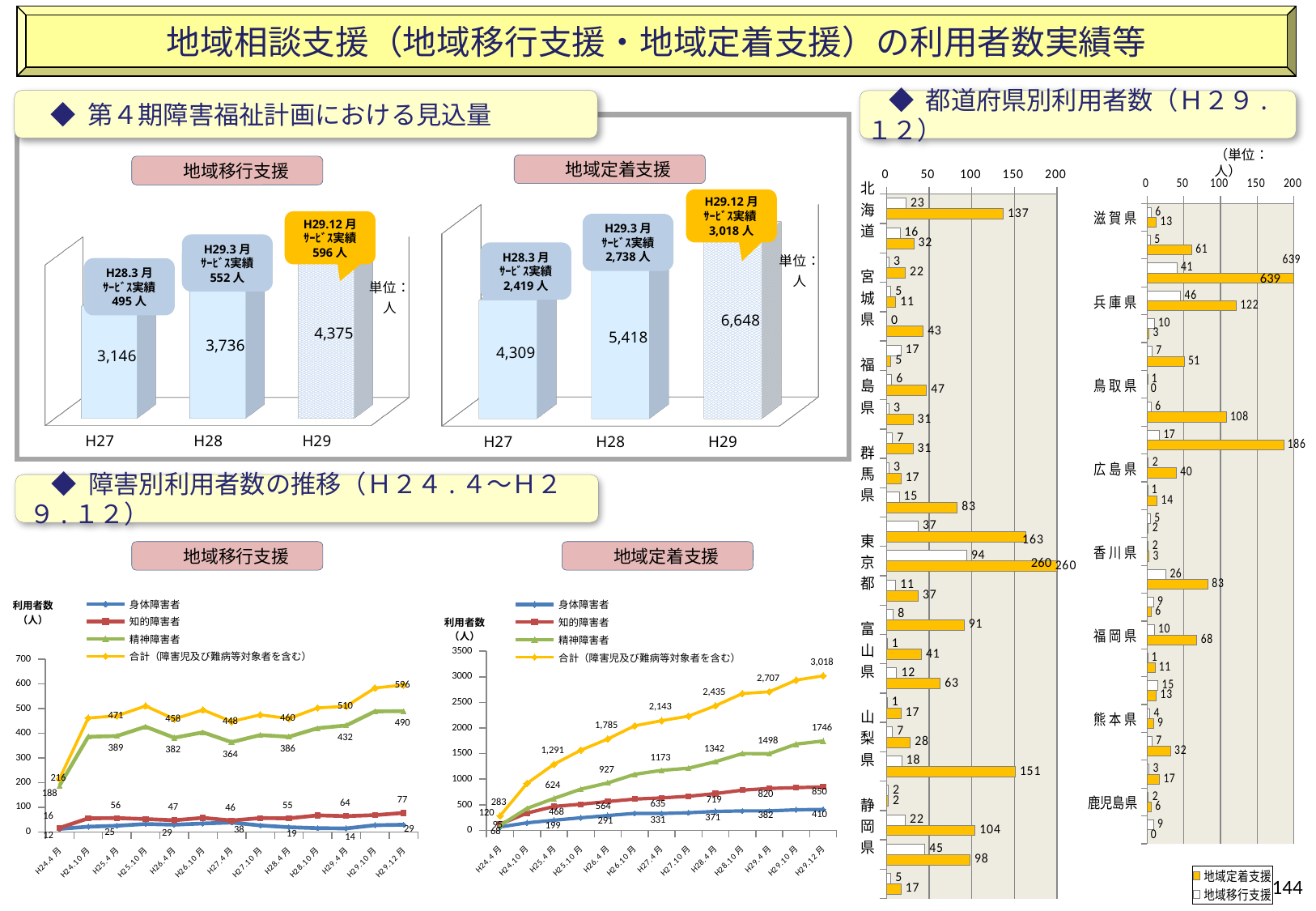
In the 第4期障害福祉計画における見込量 section, what is the 地域定着支援 value for H27? 4,309 In the 第4期障害福祉計画における見込量 section, what is the 地域移行支援 value for H29? 4,375 In the 第4期障害福祉計画における見込量 section, what is the difference between the 地域定着支援 values for H29 and H28? 1,230 In the 第4期障害福祉計画における見込量 section, do the 地域定着支援 values rise or fall from H27 to H29? rise How many series does the legend of the 障害別利用者数の推移 地域定着支援 line chart list? 4 In the 第4期障害福祉計画における見込量 section, which is larger for H28: the 地域移行支援 value or the 地域定着支援 value? 地域定着支援 In the 障害別利用者数の推移 地域定着支援 line chart, what is the 合計 value at H29.12月? 3,018 In the 障害別利用者数の推移 地域移行支援 line chart, what is the 合計 value at H29.12月? 596 In the 第4期障害福祉計画における見込量 section, what is the H29.12月 サービス実績 shown for 地域移行支援? 596人 What kind of chart is the 都道府県別利用者数（H29.12） chart on the right of the slide? bar chart In the 障害別利用者数の推移 地域移行支援 line chart, what is the 知的障害者 value at H29.12月? 77 In the 障害別利用者数の推移 地域定着支援 line chart, what is the 精神障害者 value at H29.12月? 1746